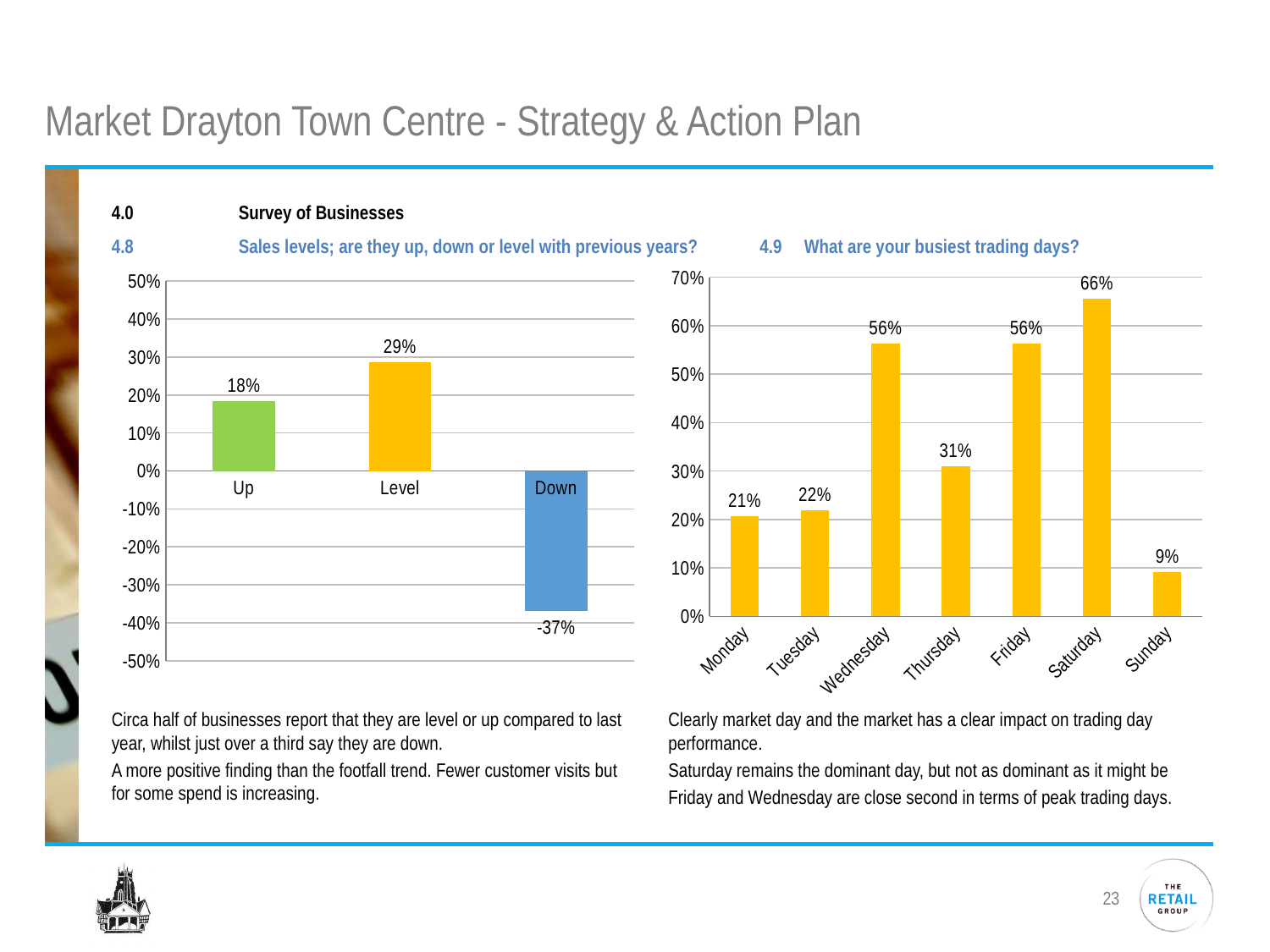
In the right chart (busiest trading days), what is the value for Thursday? 31% In the left chart (Sales levels), what is the value for Level? 29% In the left chart (Sales levels), how many categories are shown? 3 In the right chart (busiest trading days), which day has the lowest value? Sunday In the left chart (Sales levels), what is the value for Down? -37% In the right chart (busiest trading days), how many days are shown on the x axis? 7 In the right chart (busiest trading days), what is the difference between Saturday and Friday? 10% What kind of chart is the right chart (busiest trading days)? Bar chart In the left chart (Sales levels), what is the difference between the values for Level and Up? 11% In the right chart (busiest trading days), which day has the highest value? Saturday In the left chart (Sales levels), which category has the lowest value? Down In the right chart (busiest trading days), which is larger, the value for Wednesday or the value for Thursday? Wednesday